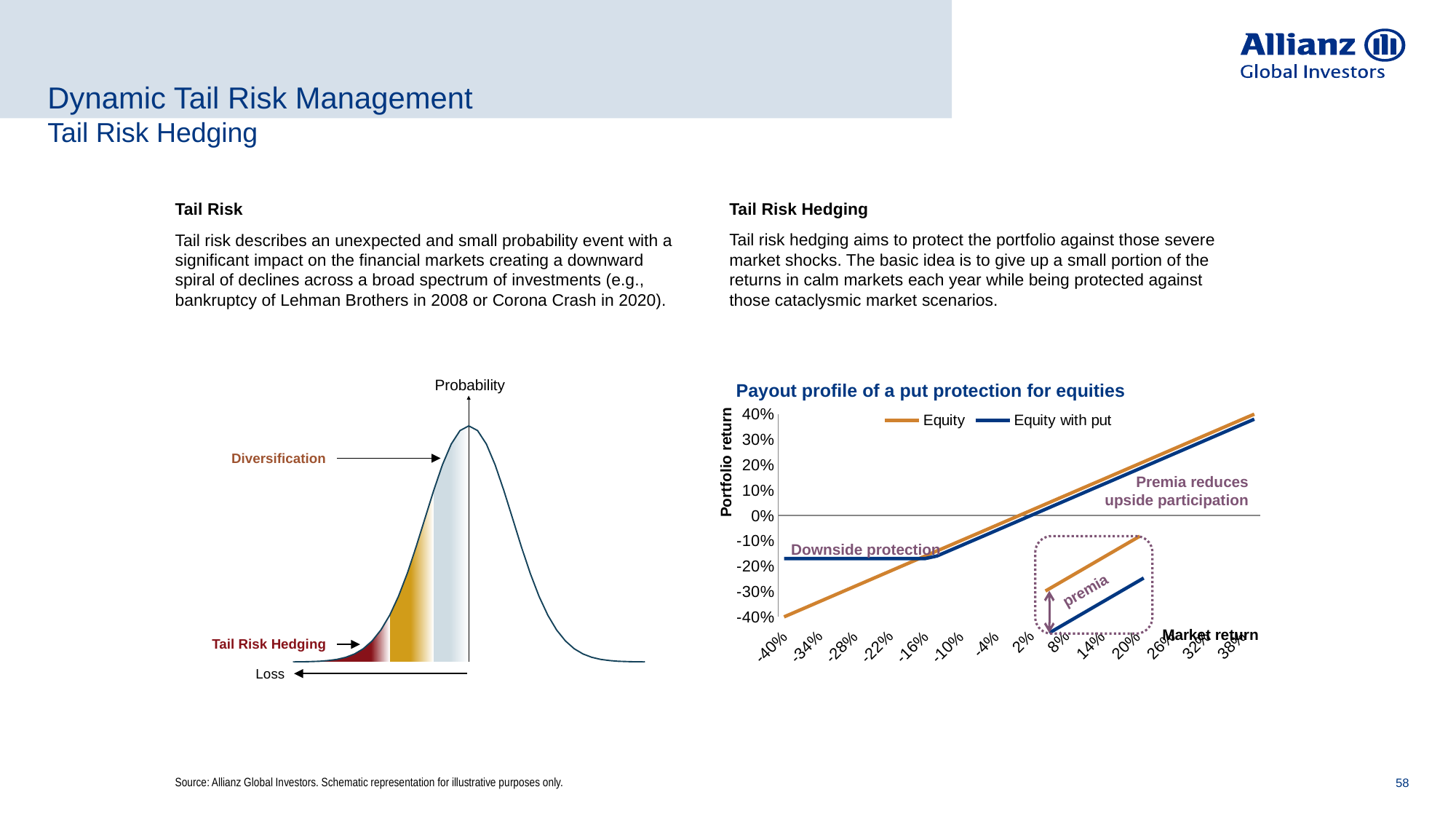
In the 'Payout profile of a put protection for equities' chart, which series has the higher portfolio return at a market return of 38%? Equity In the 'Payout profile of a put protection for equities' chart, is the Equity with put portfolio return at a market return of -40% greater or less than -30%? greater In the 'Payout profile of a put protection for equities' chart, is the Equity with put portfolio return at a market return of 38% greater or less than 30%? greater In the 'Payout profile of a put protection for equities' chart, what are the two series named in the legend? Equity and Equity with put In the 'Payout profile of a put protection for equities' chart, which series has the higher portfolio return at a market return of -40%? Equity with put In the 'Payout profile of a put protection for equities' chart, is the Equity portfolio return at a market return of -40% greater or less than -30%? less In the 'Payout profile of a put protection for equities' chart, what is the label of the vertical axis? Portfolio return What kind of chart is the 'Payout profile of a put protection for equities' chart? line chart How many tick labels are shown on the x axis of the 'Payout profile of a put protection for equities' chart? 14 In the 'Payout profile of a put protection for equities' chart, does the Equity line rise or fall as market return increases along the x axis? rise How many series does the legend of the 'Payout profile of a put protection for equities' chart list? 2